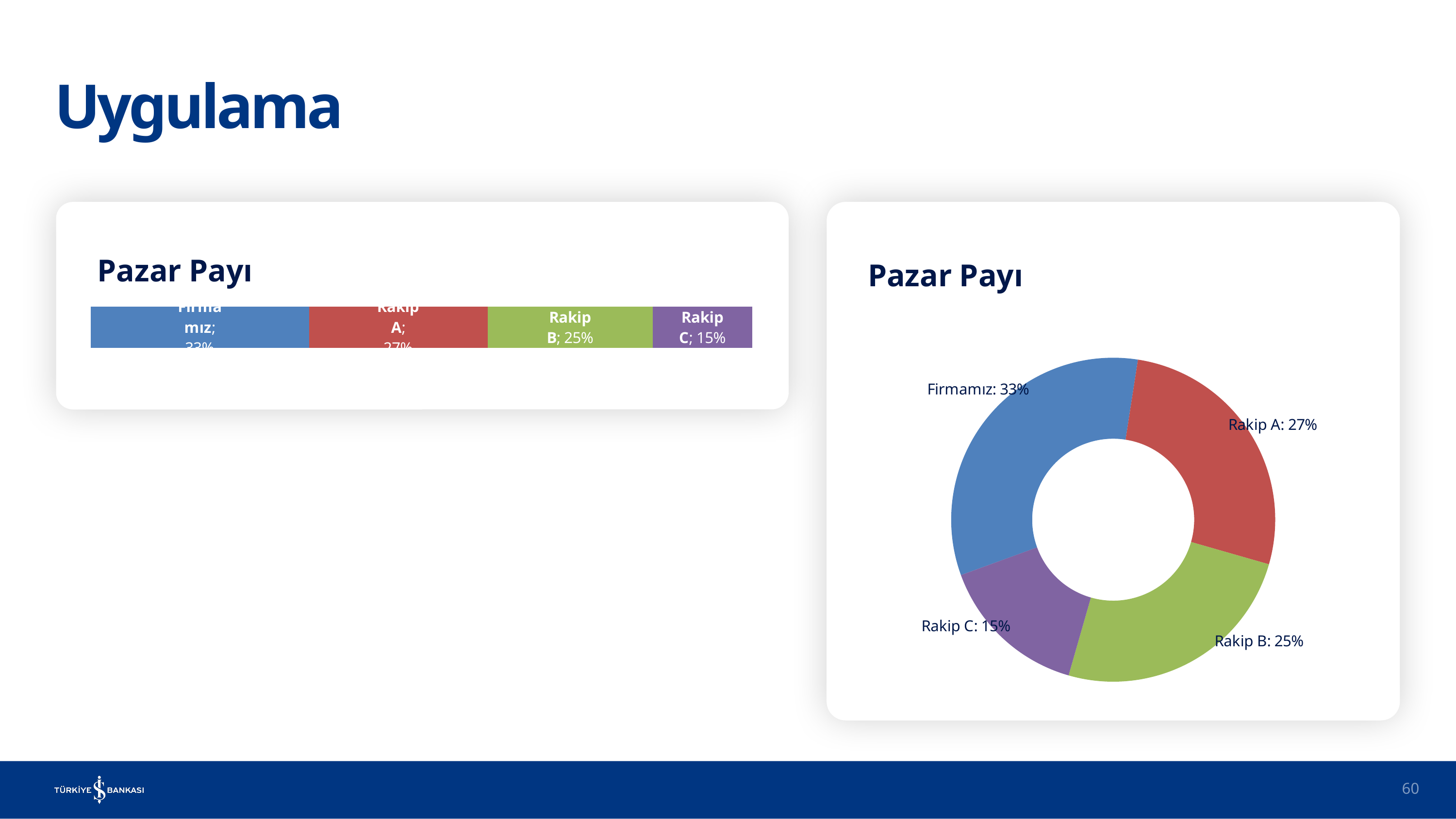
On the doughnut chart on the right, what is the difference between the shares of Firmamız and Rakip C? 18% On the stacked bar chart on the left, what is the value for Rakip B? 25% On the doughnut chart on the right, which is larger, the share of Rakip A or Rakip B? Rakip A On the doughnut chart on the right, which category has the largest share? Firmamız What is the title of the chart on the right? Pazar Payı What kind of chart is shown on the right of the slide? Doughnut chart On the stacked bar chart on the left, what is the value for Rakip C? 15% What kind of chart is shown on the left of the slide? Bar chart On the doughnut chart on the right, what is the share for Rakip A? 27% On the doughnut chart on the right, which category has the smallest share? Rakip C How many categories are shown on the doughnut chart on the right? 4 On the doughnut chart on the right, what is the share for Firmamız? 33%